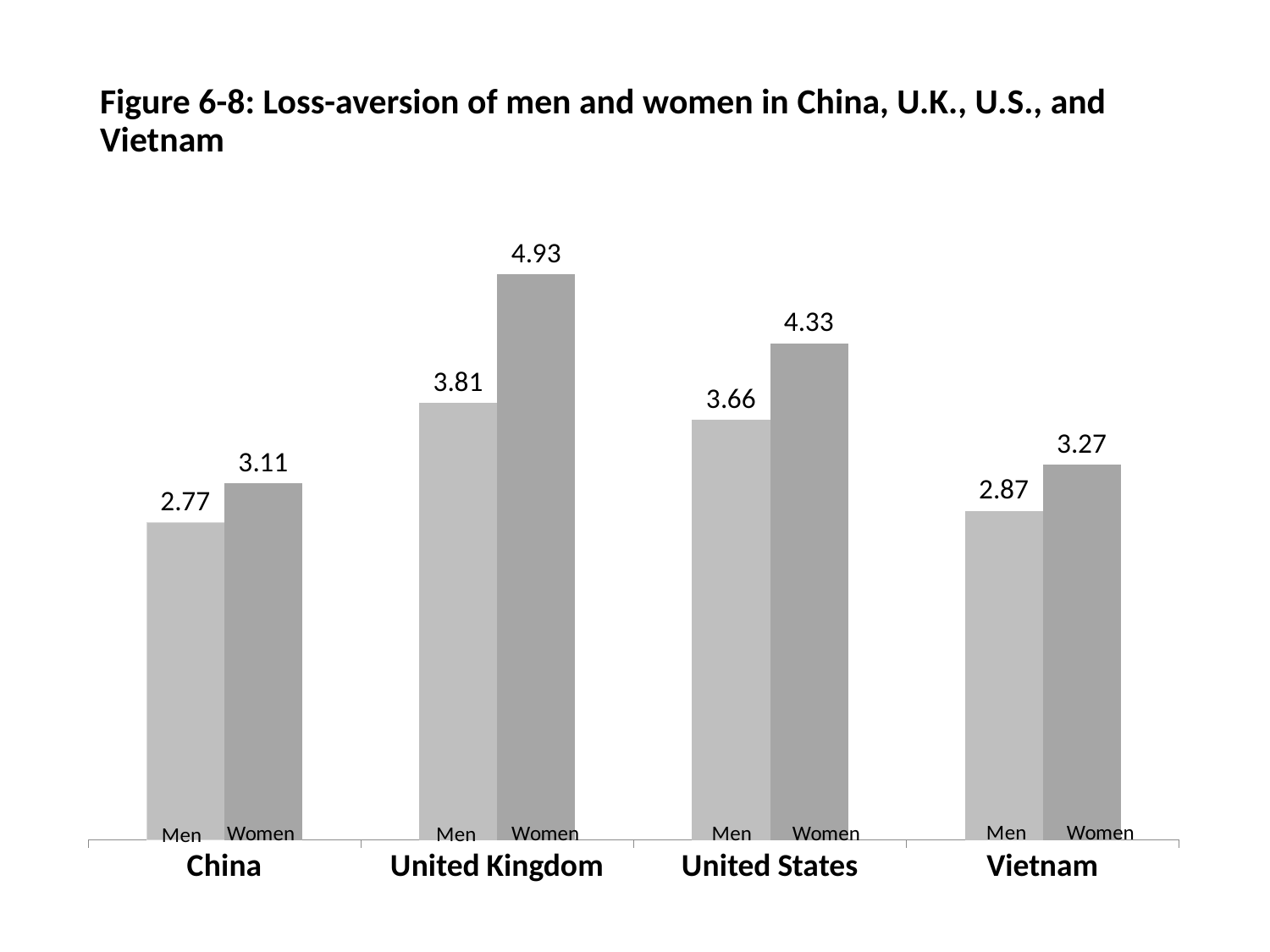
How many countries are shown on the chart? 4 What is the difference between the women's and men's loss-aversion values in the United Kingdom? 1.12 What is the loss-aversion value for men in the United States? 3.66 Which country has the lowest loss-aversion value for men? China What is the loss-aversion value for women in Vietnam? 3.27 What is the title of the chart? Figure 6-8: Loss-aversion of men and women in China, U.K., U.S., and Vietnam What is the loss-aversion value for men in China? 2.77 What is the loss-aversion value for women in the United Kingdom? 4.93 Which country has the highest loss-aversion value for women? United Kingdom What is the difference between the women's loss-aversion values in the United States and China? 1.22 What kind of chart is shown on the slide? Bar chart Which is larger, the loss-aversion value for men in the United Kingdom or for men in the United States? Men in the United Kingdom